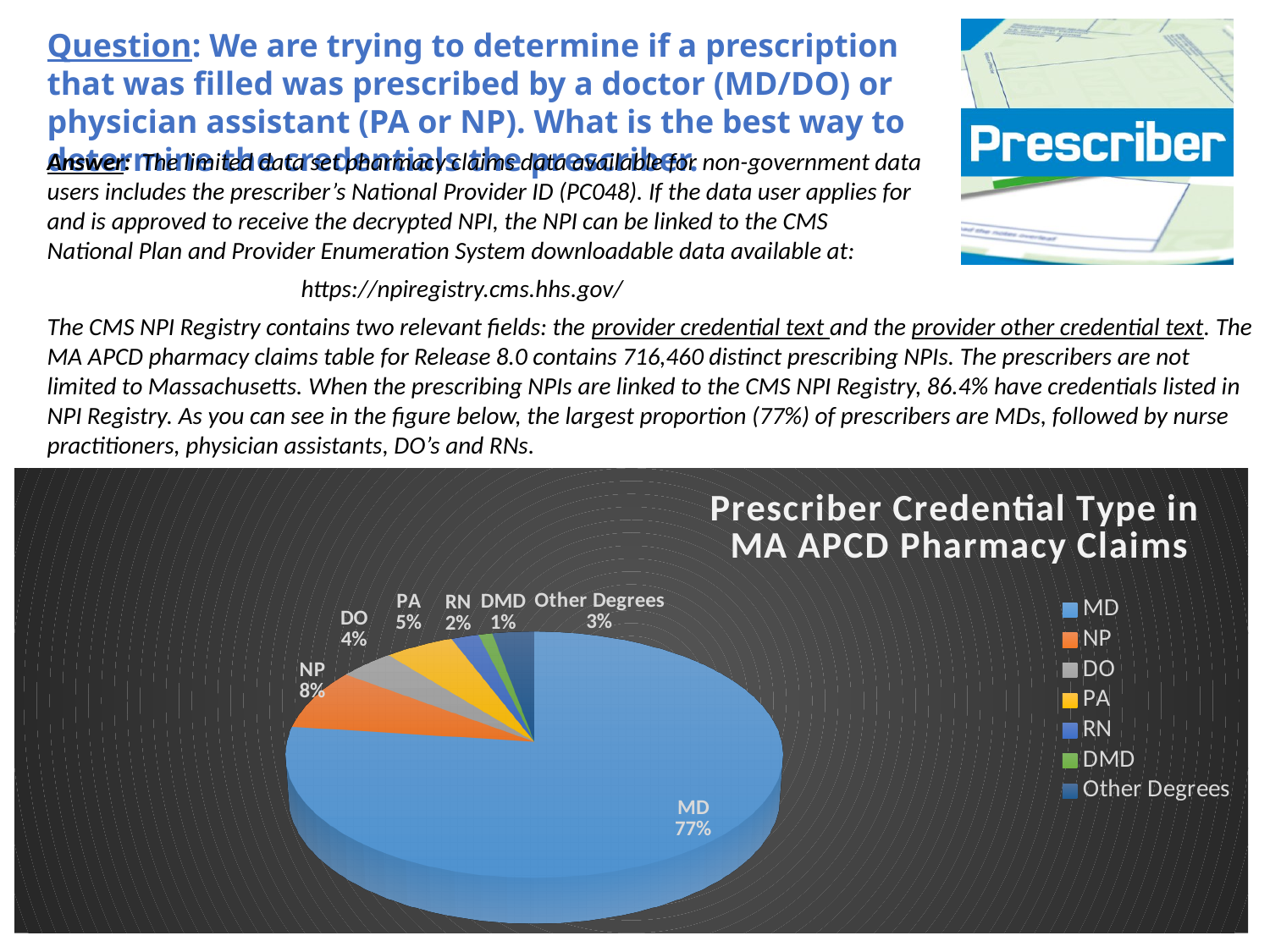
Which credential type has the smallest share of the pie? DMD What share of prescribers are PAs? 5% What is the title of the chart? Prescriber Credential Type in MA APCD Pharmacy Claims What share of prescribers are DOs? 4% What share of prescribers are MDs? 77% What is the difference in percentage points between the NP share and the PA share? 3% What type of chart is shown on the slide? pie chart What share of prescribers have Other Degrees? 3% Which has a larger share, DO or RN? DO How many credential categories does the legend list? 7 What share of prescribers are NPs? 8% Which credential type has the largest share of the pie? MD